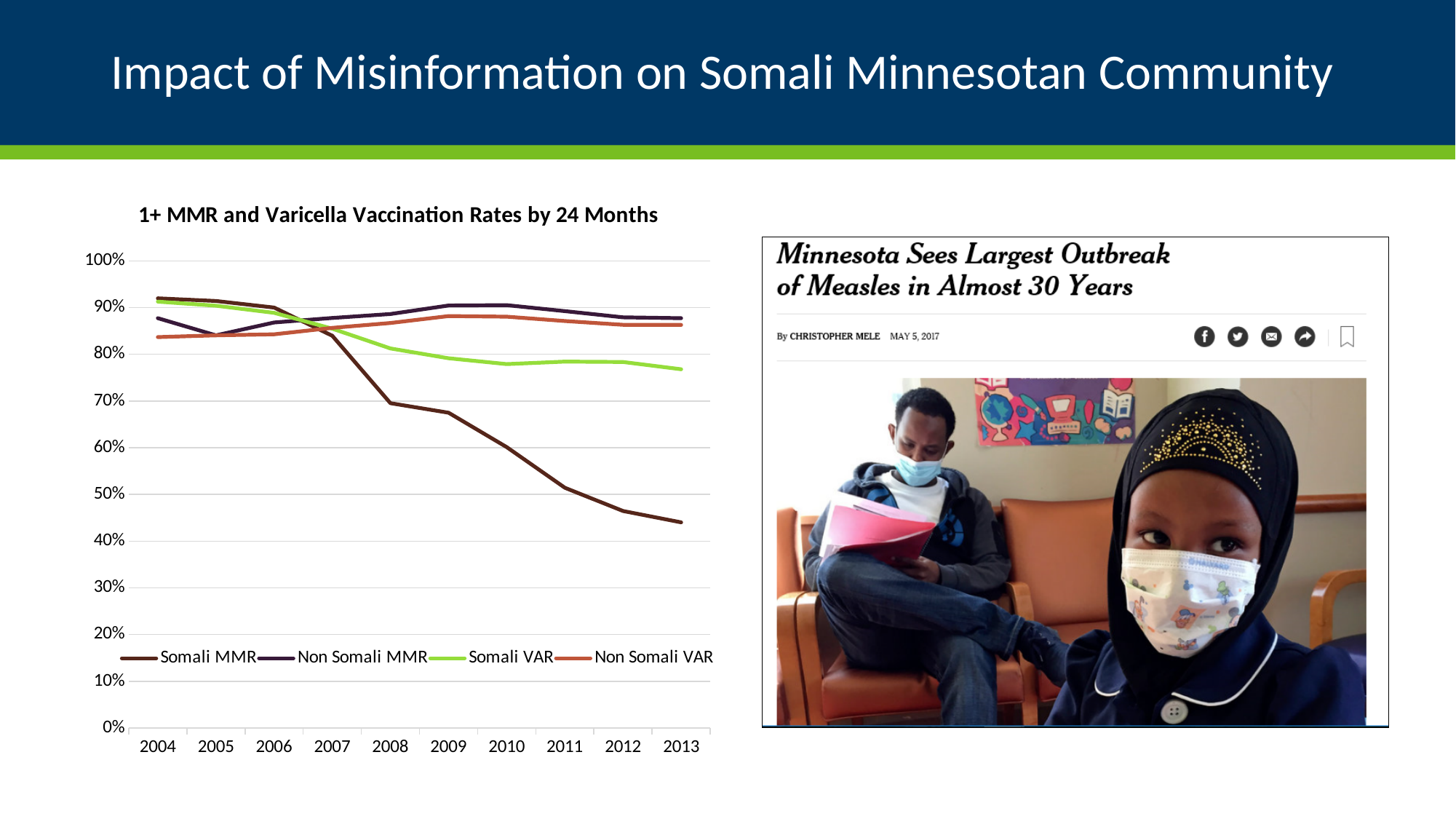
Is the value for Non Somali MMR in 2013 greater or less than 80%? greater How many series does the chart legend list? 4 Does the Somali MMR series rise or fall from 2004 to 2013? Fall Does the Somali VAR series rise or fall from 2004 to 2013? Fall Is the value for Somali MMR in 2004 greater or less than 90%? greater Is the value for Somali VAR in 2013 greater or less than 80%? less What is the title of the chart? 1+ MMR and Varicella Vaccination Rates by 24 Months Which series has the lowest value in 2013? Somali MMR What kind of chart is shown on the slide? Line chart In 2013, which is larger: Somali MMR or Non Somali MMR? Non Somali MMR How many years are shown on the x axis of the chart? 10